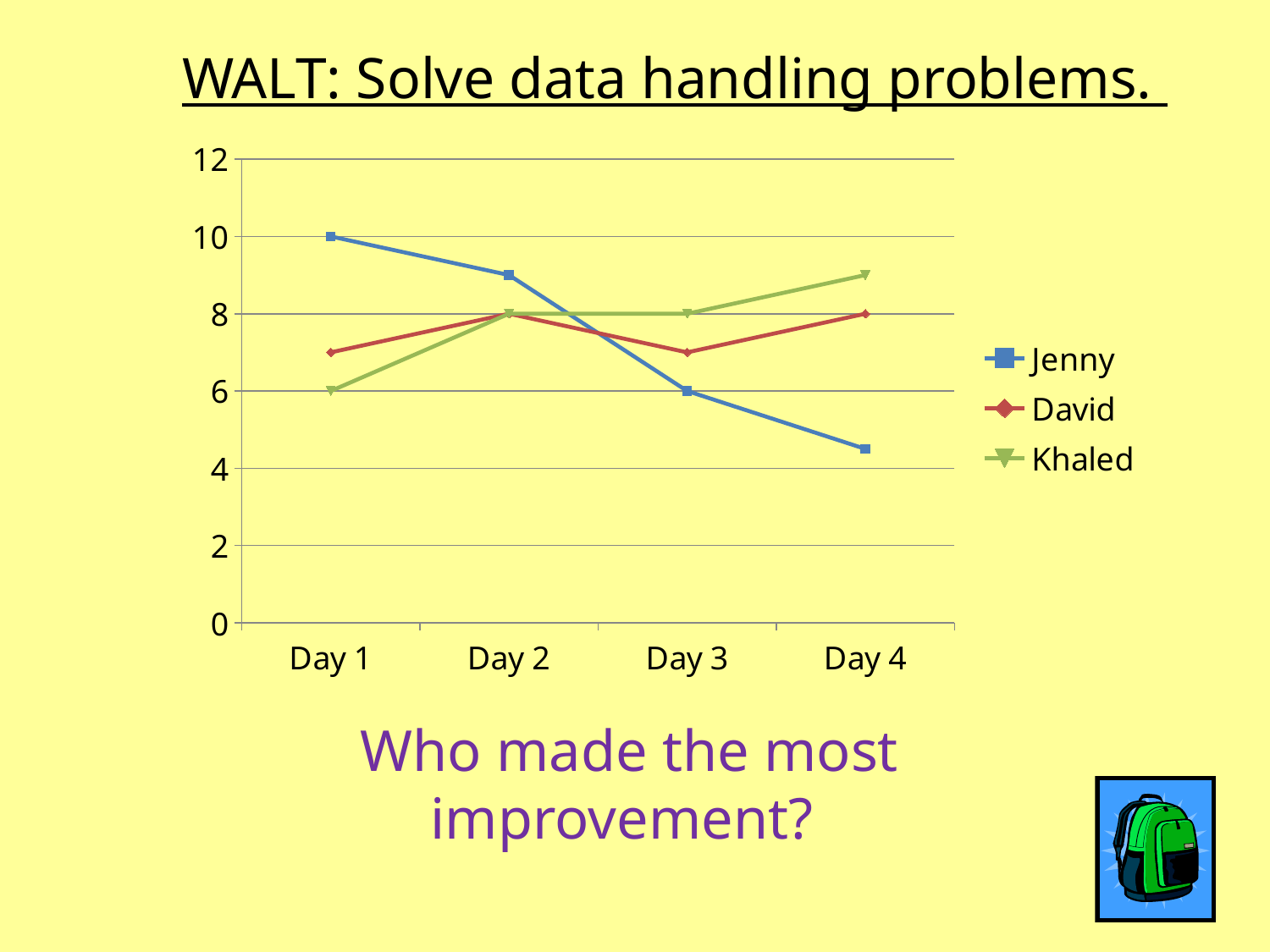
How many days are shown on the x axis? 4 What kind of chart is shown on the slide? line chart What is Jenny's value on Day 3? 6 Which is larger on Day 1, Jenny's value or David's value? Jenny Is Jenny's value on Day 4 greater or less than 6? less How many series does the legend list? 3 What is Khaled's value on Day 1? 6 Is Khaled's value on Day 4 greater or less than 8? greater Do Jenny's values rise or fall from Day 1 to Day 4? fall What is Jenny's value on Day 1? 10 Which series has the highest value on Day 4? Khaled What is David's value on Day 2? 8